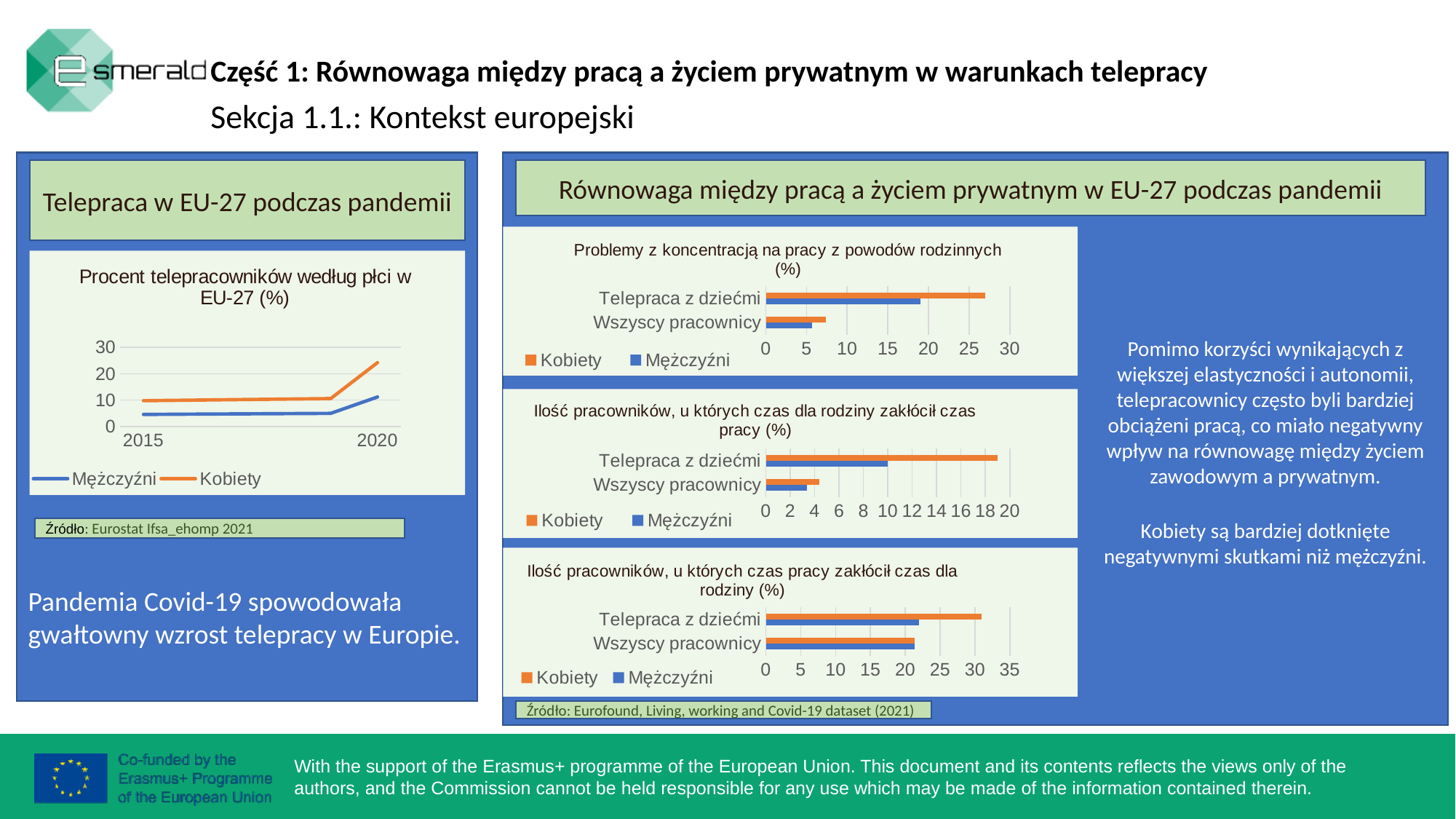
In the chart "Ilość pracowników, u których czas pracy zakłócił czas dla rodziny (%)", which colour represents Kobiety? orange What kind of chart is "Procent telepracowników według płci w EU-27 (%)"? line chart How many series does the legend of the chart "Procent telepracowników według płci w EU-27 (%)" list? 2 In the chart "Ilość pracowników, u których czas dla rodziny zakłócił czas pracy (%)", is the value for Kobiety in Telepraca z dziećmi greater or less than 16? greater In the chart "Ilość pracowników, u których czas pracy zakłócił czas dla rodziny (%)", is the value for Mężczyźni in Telepraca z dziećmi greater or less than 25? less In the chart "Problemy z koncentracją na pracy z powodów rodzinnych (%)", which is larger for Telepraca z dziećmi: Kobiety or Mężczyźni? Kobiety What kind of chart is "Problemy z koncentracją na pracy z powodów rodzinnych (%)"? bar chart In the chart "Procent telepracowników według płci w EU-27 (%)", does the value for Kobiety rise or fall from 2015 to 2020? rise In the chart "Procent telepracowników według płci w EU-27 (%)", is the value for Mężczyźni in 2015 greater or less than 10? less How many categories are shown in the chart "Ilość pracowników, u których czas dla rodziny zakłócił czas pracy (%)"? 2